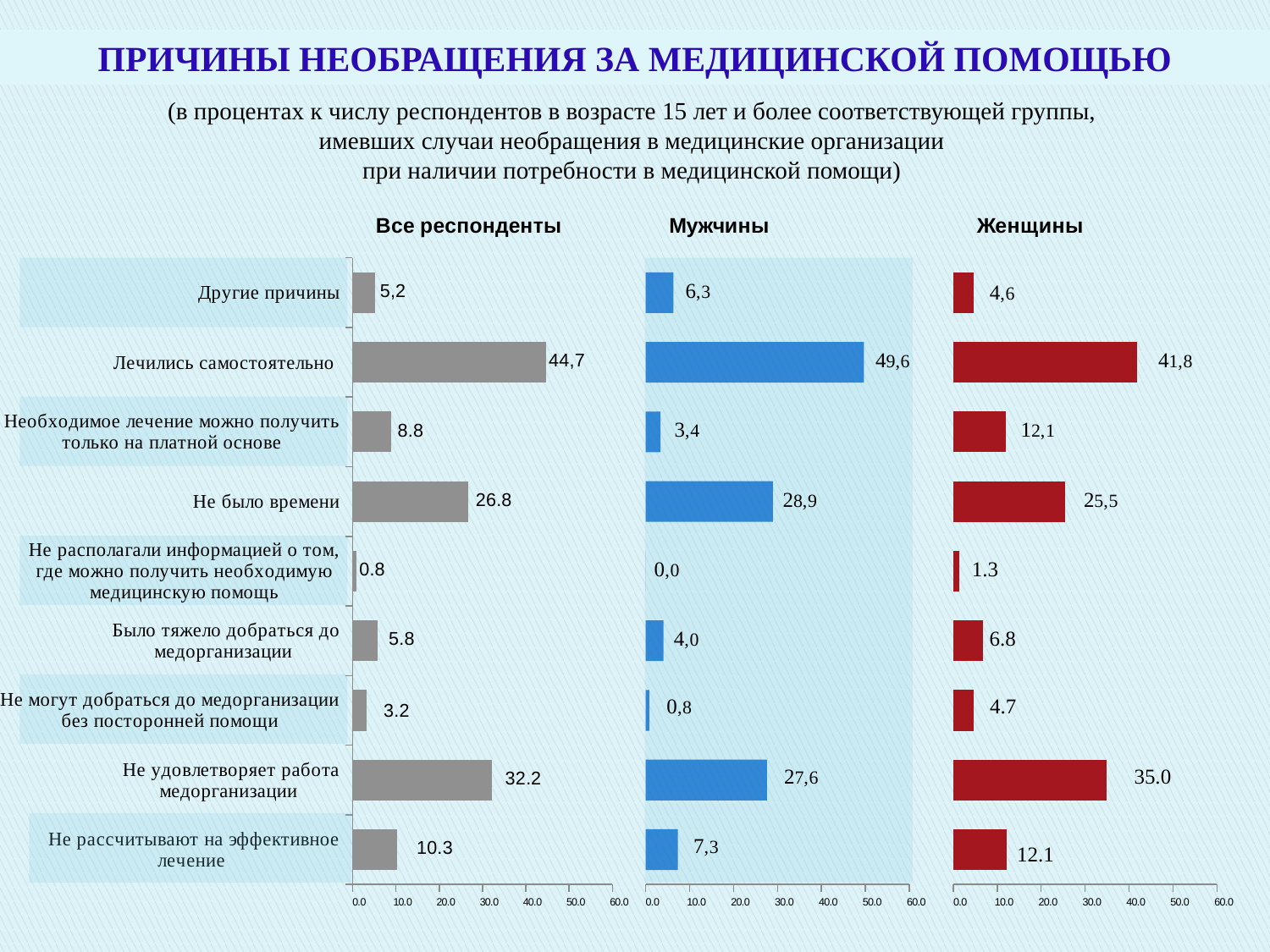
In the "Мужчины" chart, what is the value for "Не располагали информацией о том, где можно получить необходимую медицинскую помощь"? 0,0 What colour are the bars in the "Женщины" chart? dark red In the "Все респонденты" chart, what is the value for "Лечились самостоятельно"? 44,7 In the "Мужчины" chart, what is the value for "Не было времени"? 28,9 Which is larger: the value for "Необходимое лечение можно получить только на платной основе" in the "Мужчины" chart or in the "Женщины" chart? Женщины What type of chart is used for the "Мужчины" data? bar chart In the "Женщины" chart, is the value for "Лечились самостоятельно" greater or less than 40.0? greater In the "Мужчины" chart, which category has the highest value? Лечились самостоятельно In the "Все респонденты" chart, what is the difference between "Лечились самостоятельно" and "Не удовлетворяет работа медорганизации"? 12.5 In the "Женщины" chart, what is the value for "Не удовлетворяет работа медорганизации"? 35.0 How many categories are shown in the "Все респонденты" chart? 9 In the "Женщины" chart, which category has the lowest value? Не располагали информацией о том, где можно получить необходимую медицинскую помощь